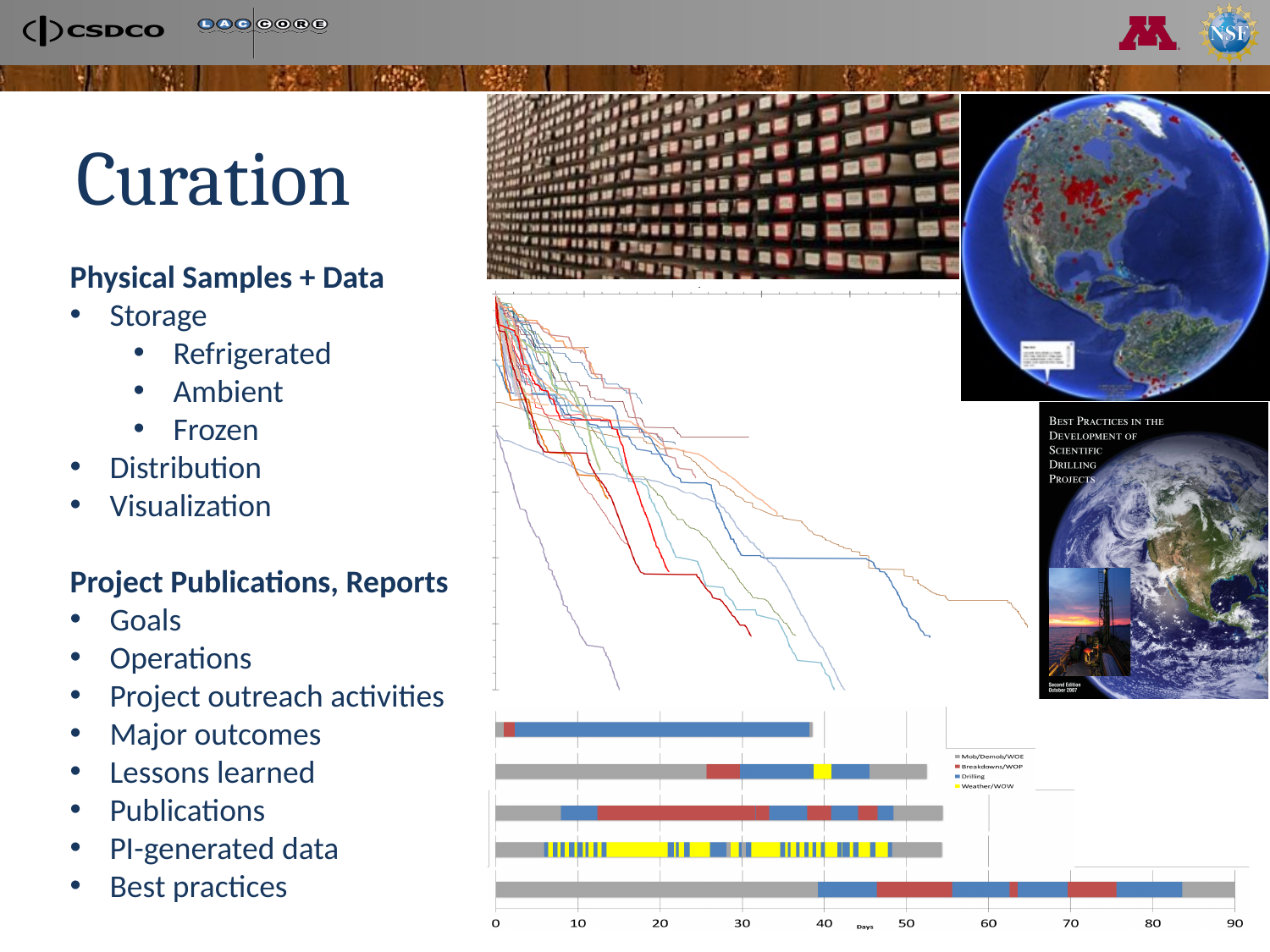
Which bar in the bottom bar chart is the longest? the bottommost bar In the middle line chart, do the curves generally rise or fall from left to right? fall Which bar in the bottom bar chart is the shortest? the topmost bar What are the legend entries of the bottom bar chart? Mob/Demob/WOE, Breakdowns/WOP, Drilling, Weather/WOW In the bottom bar chart, is the total length of the bottommost bar greater or less than 80 days? greater In the bottom bar chart, is the total length of the topmost bar greater or less than 40 days? less What kind of chart is the chart in the middle of the slide with the many coloured curves? line chart In the bottom bar chart, is the total length of the second bar from the top greater or less than 50 days? greater How many series does the legend of the bottom bar chart list? 4 How many bars are plotted in the bottom bar chart? 5 What is the label of the horizontal axis of the bottom bar chart? Days What kind of chart is the chart at the bottom of the slide with the Days axis? bar chart